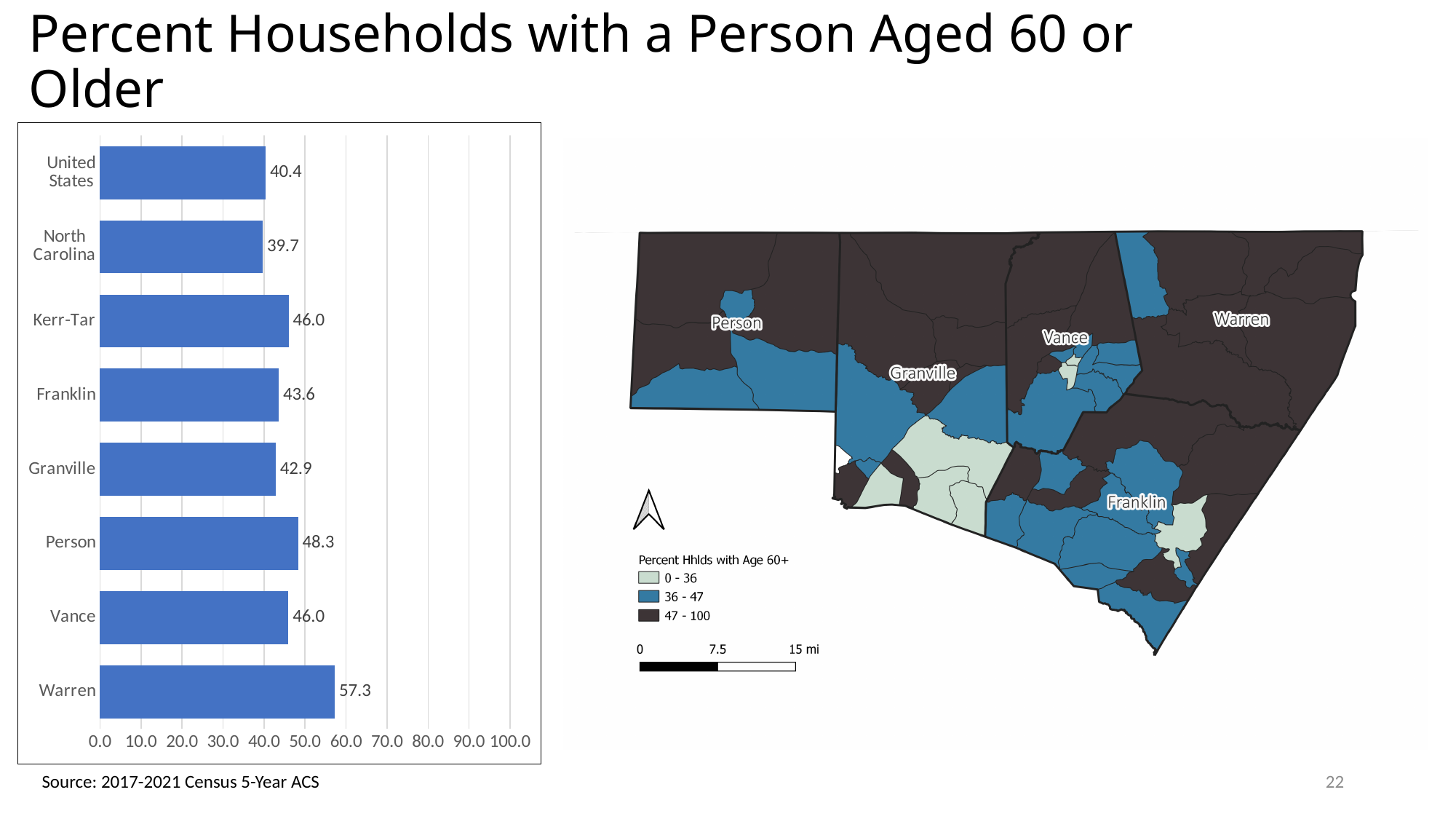
What is the value for Person in the bar chart? 48.3 Which category has the highest value in the bar chart? Warren What is the value for North Carolina in the bar chart? 39.7 What is the difference between the values for Warren and the United States in the bar chart? 16.9 What is the highest value shown on the x axis of the bar chart? 100.0 What kind of chart is shown on the left of the slide? bar chart How many categories are shown in the bar chart? 8 Which is larger in the bar chart, the value for Franklin or the value for Granville? Franklin What is the value for Warren in the bar chart? 57.3 Which category has the lowest value in the bar chart? North Carolina Is the value for Warren in the bar chart greater or less than 50.0? greater What is the difference between the values for Person and Granville in the bar chart? 5.4